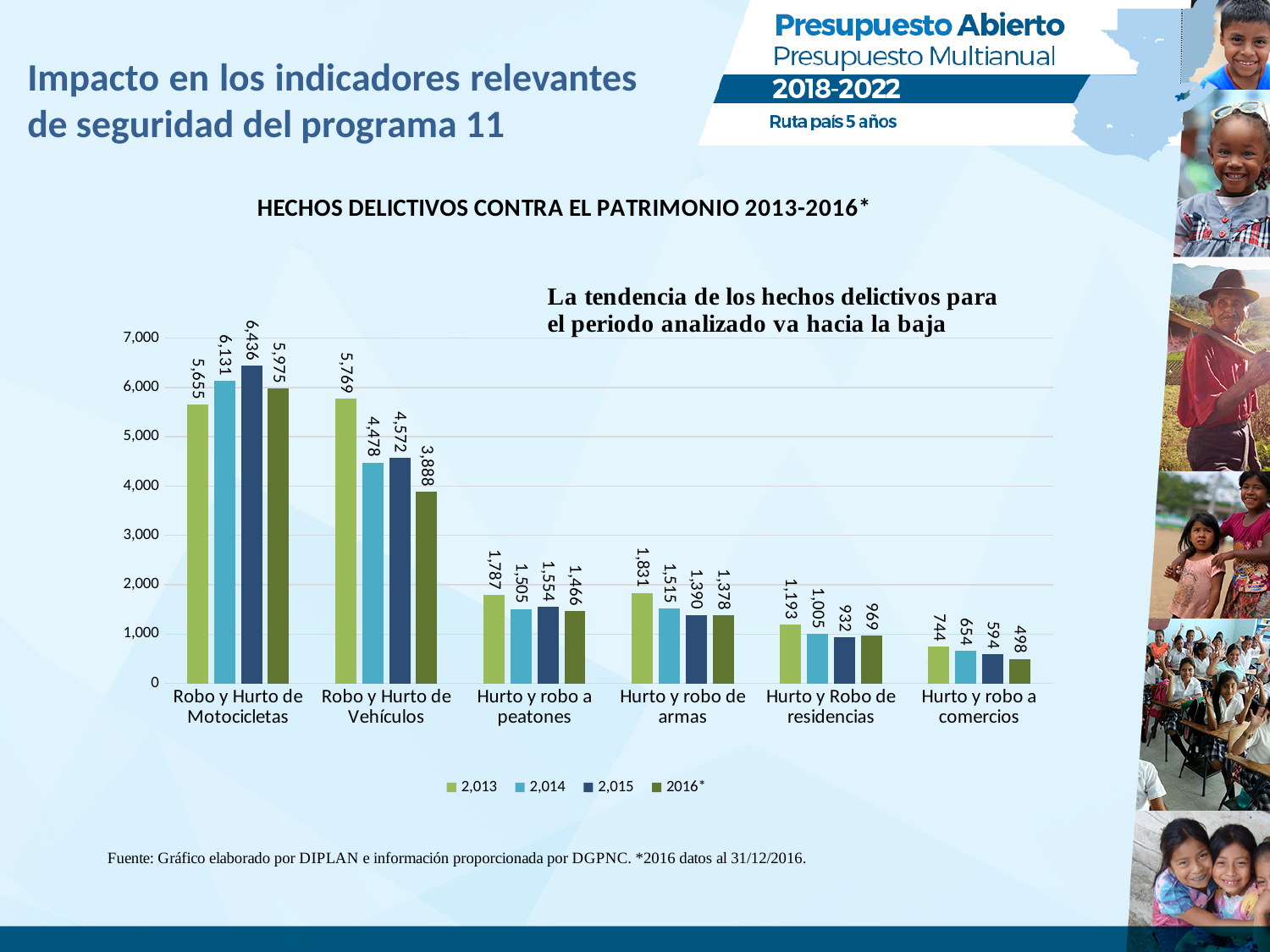
What is the value for Hurto y robo a comercios in 2016*? 498 Do the values for Hurto y robo a comercios rise or fall from 2,013 to 2016*? fall What is the difference between the 2,013 and 2016* values for Robo y Hurto de Vehículos? 1,881 Which category has the lowest value in 2016*? Hurto y robo a comercios What is the value for Robo y Hurto de Vehículos in 2,013? 5,769 Which is larger for Hurto y robo de armas: the 2,013 value or the 2016* value? 2,013 What is the title of the chart? HECHOS DELICTIVOS CONTRA EL PATRIMONIO 2013-2016* What type of chart is shown on the slide? bar chart Which category has the highest value in 2,014? Robo y Hurto de Motocicletas What is the value for Robo y Hurto de Motocicletas in 2,015? 6,436 How many series does the legend list? 4 How many categories are shown on the x axis? 6